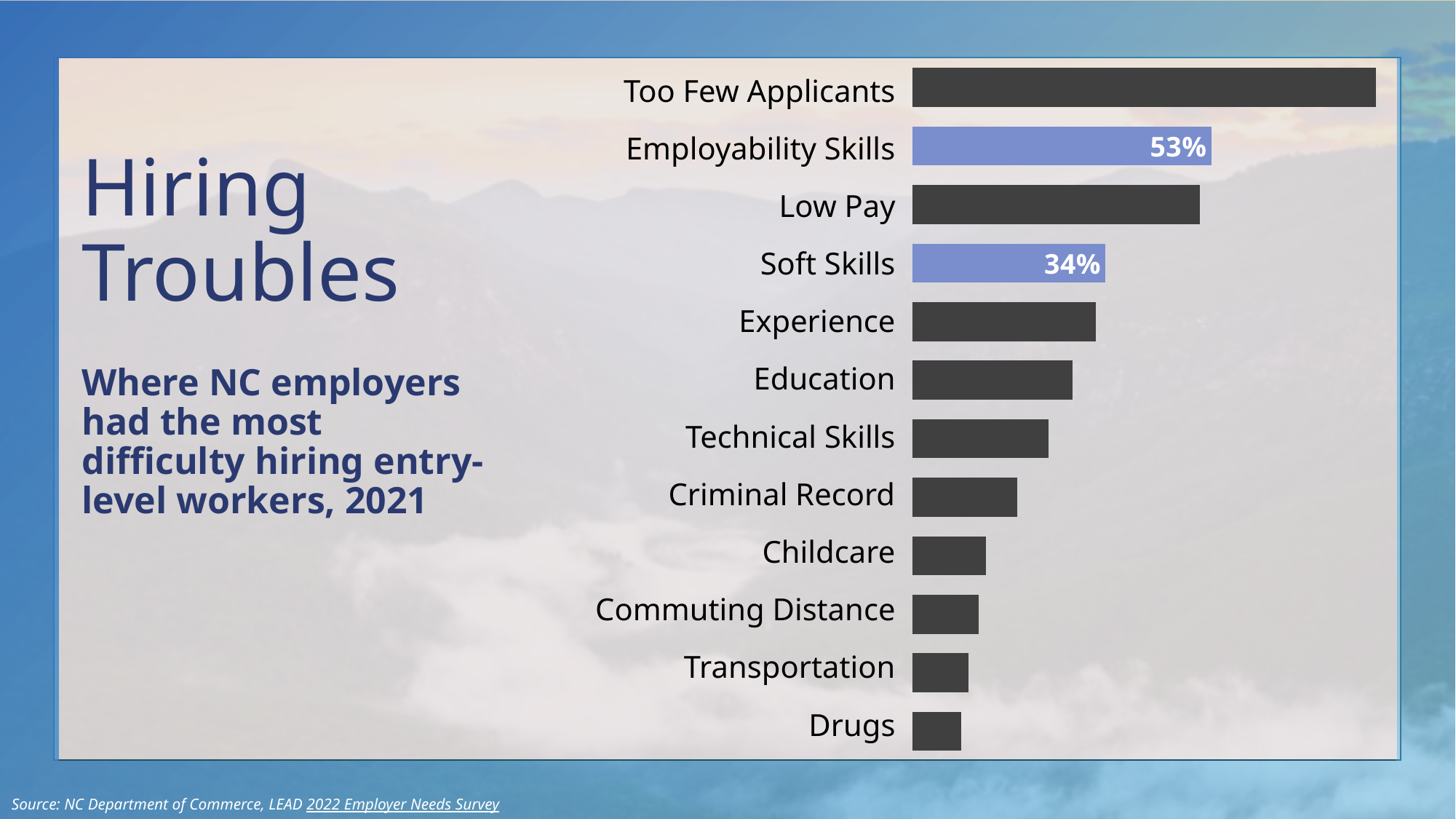
Which category has the longest bar? Too Few Applicants What is the value for Employability Skills? 53% What is the title of the slide containing the chart? Hiring Troubles What is the value for Soft Skills? 34% What is the difference between the values for Employability Skills and Soft Skills? 19 percentage points What kind of chart is shown on the slide? Bar chart Which category has the shortest bar? Drugs Which is larger, the value for Childcare or the value for Criminal Record? Criminal Record How many categories are shown in the chart? 12 Which two categories are highlighted in blue rather than dark grey? Employability Skills and Soft Skills Do the bar lengths increase or decrease from the top category to the bottom category? Decrease Which is larger, the value for Low Pay or the value for Experience? Low Pay